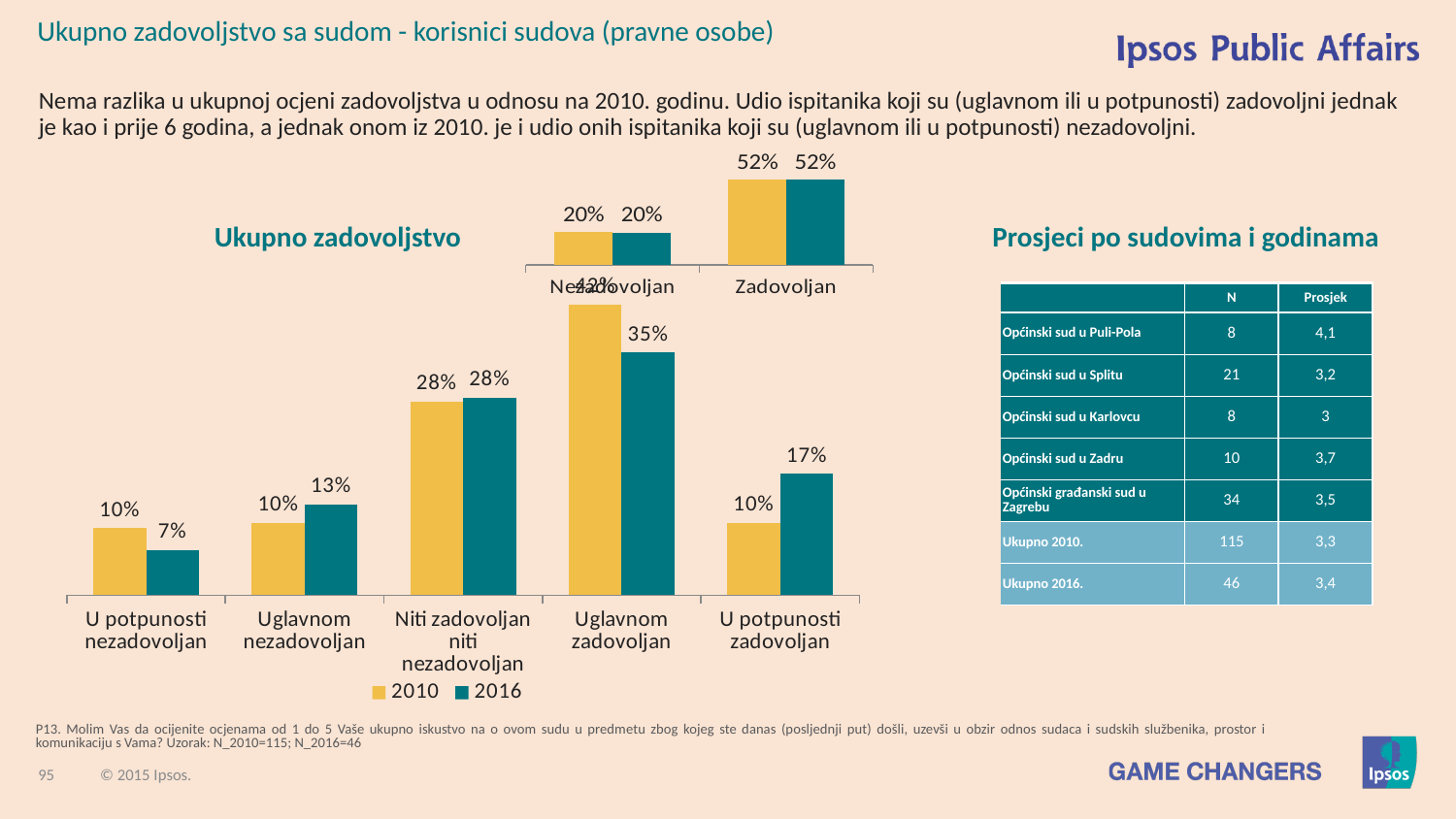
In the 'Ukupno zadovoljstvo' chart, what is the 2016 value for 'Uglavnom zadovoljan'? 35% In the 'Ukupno zadovoljstvo' chart, what is the 2016 value for 'U potpunosti zadovoljan'? 17% In the 'Ukupno zadovoljstvo' chart, for 'Uglavnom nezadovoljan', which year has the larger value, 2010 or 2016? 2016 How many categories are shown on the x axis of the 'Ukupno zadovoljstvo' chart? 5 In the small chart at the top of the slide with categories 'Nezadovoljan' and 'Zadovoljan', what is the 2016 value for 'Zadovoljan'? 52% In the 'Ukupno zadovoljstvo' chart, what is the 2010 value for 'Niti zadovoljan niti nezadovoljan'? 28% In the 'Ukupno zadovoljstvo' chart, which category has the highest 2016 value? Uglavnom zadovoljan What type of chart is the 'Ukupno zadovoljstvo' chart? Bar chart How many series does the legend of the 'Ukupno zadovoljstvo' chart list? 2 In the 'Ukupno zadovoljstvo' chart, which category has the lowest 2016 value? U potpunosti nezadovoljan In the 'Ukupno zadovoljstvo' chart, what is the difference between the 2016 and 2010 values for 'U potpunosti zadovoljan'? 7% In the 'Ukupno zadovoljstvo' chart, what is the 2016 value for 'U potpunosti nezadovoljan'? 7%